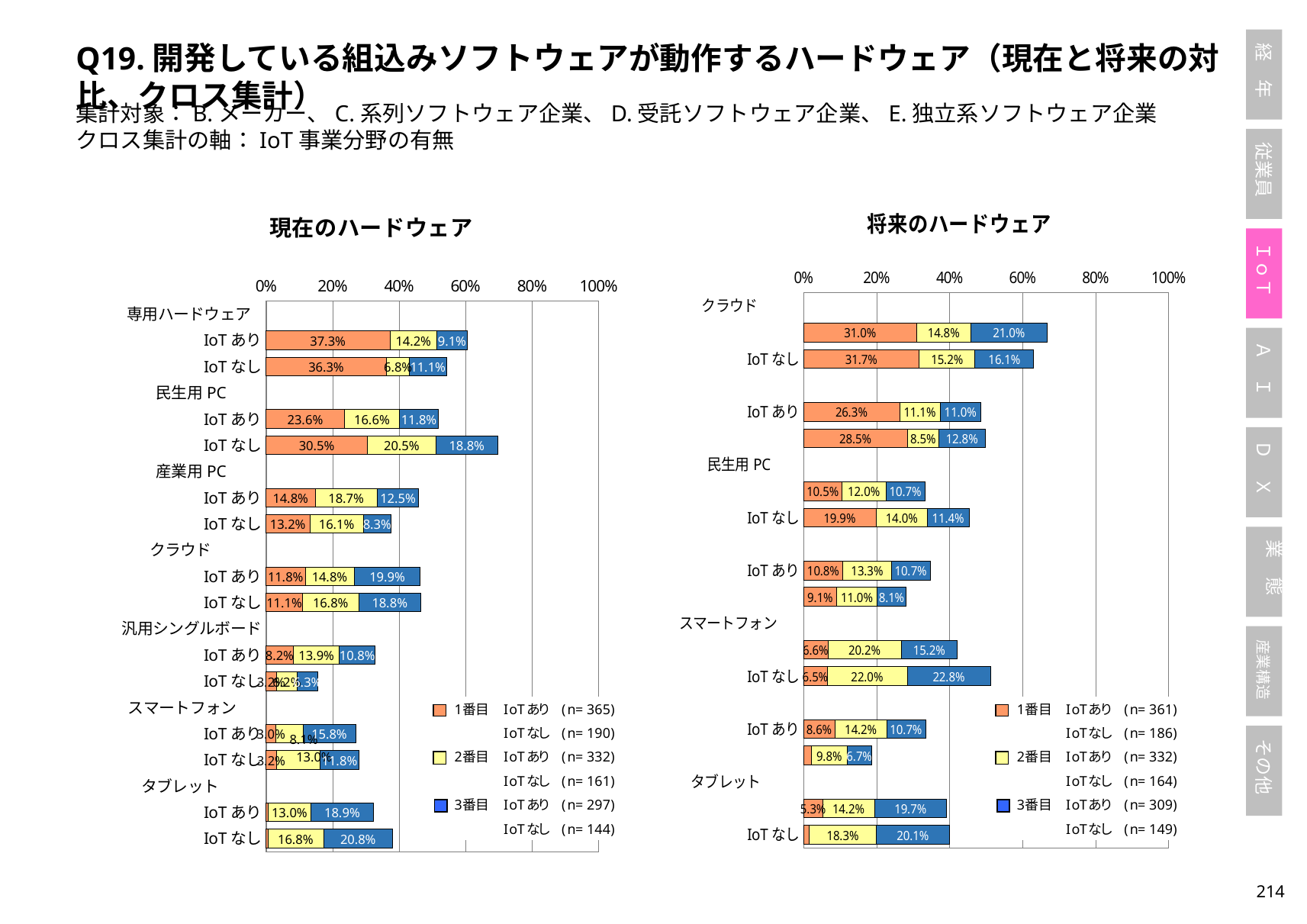
In the 現在のハードウェア chart, what is the 2番目 value for 民生用 PC IoT なし? 20.5% In the 現在のハードウェア chart, which bar has the highest 1番目 value? 専用ハードウェア IoT あり (37.3%) In the 現在のハードウェア chart, what is the difference between the 1番目 values for 民生用 PC IoT なし and 民生用 PC IoT あり? 6.9 percentage points What kind of chart is the 現在のハードウェア chart? bar chart In the 現在のハードウェア chart, what is the 1番目 value for 専用ハードウェア IoT あり? 37.3% How many hardware categories are listed in the 現在のハードウェア chart? 7 In the 将来のハードウェア chart, what is the 1番目 value of the topmost bar? 31.0% How many series does the legend of the 現在のハードウェア chart list? 3 In the 現在のハードウェア chart legend, what is the n for 1番目 IoT あり? 365 In the 現在のハードウェア chart, what is the total of the stacked bar for 専用ハードウェア IoT あり? 60.6% In the 現在のハードウェア chart, which has the larger 3番目 value: クラウド IoT あり or 産業用 PC IoT あり? クラウド IoT あり In the 将来のハードウェア chart legend, what is the n for 3番目 IoT なし? 149